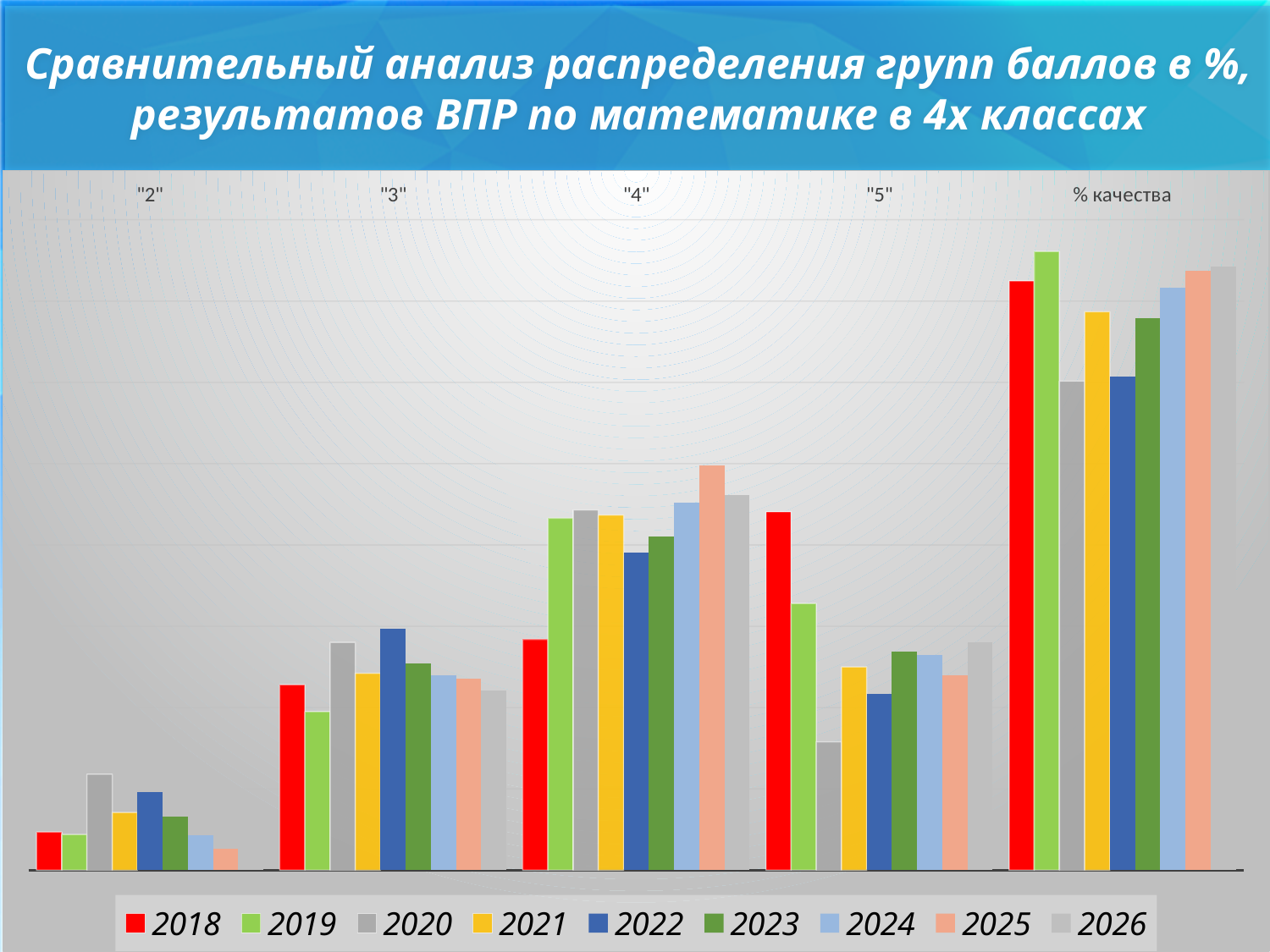
Which year has the highest bar in the "2" category? 2020 Which year has the highest bar in the "3" category? 2022 How many categories are shown along the x axis of the chart? 5 In the "5" category, which is larger: the bar for 2018 or the bar for 2019? 2018 What kind of chart is shown on the slide? bar chart How many series does the chart legend list? 9 Which year has the highest bar in the "% качества" category? 2019 Which year is shown in red in the chart legend? 2018 Which year has the lowest bar in the "5" category? 2020 Which year has the lowest bar in the "4" category? 2018